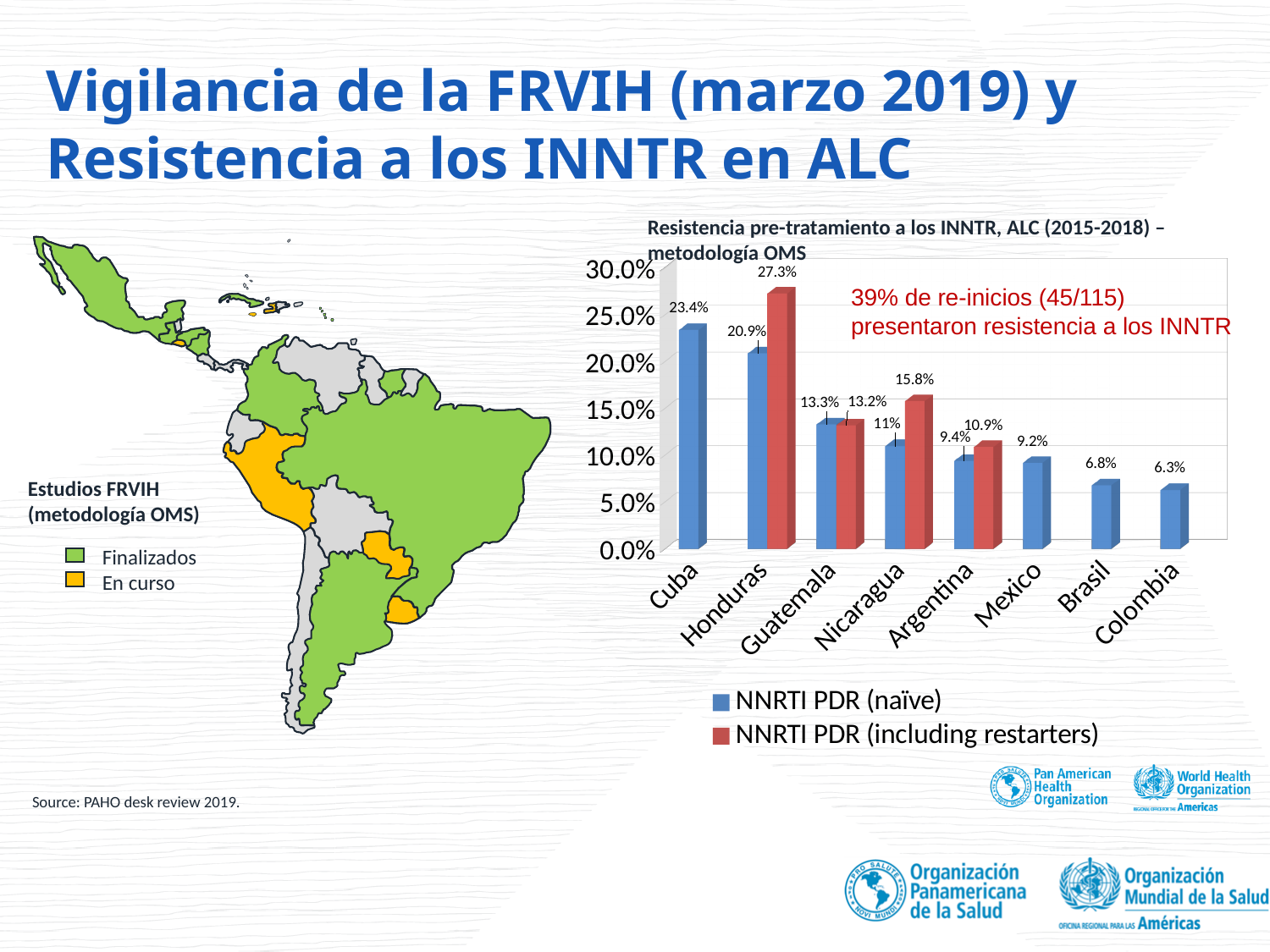
How many countries are shown on the x axis of the chart? 8 What kind of chart is shown on the slide? bar chart What is the difference between the NNRTI PDR (including restarters) and NNRTI PDR (naïve) values for Honduras? 6.4% Which is larger for Nicaragua: NNRTI PDR (naïve) or NNRTI PDR (including restarters)? NNRTI PDR (including restarters) What is the NNRTI PDR (including restarters) value for Honduras? 27.3% Which country has the lowest NNRTI PDR (naïve) value? Colombia What colour represents the NNRTI PDR (including restarters) series? red What is the NNRTI PDR (naïve) value for Cuba? 23.4% How many series does the chart legend list? 2 Which country has the highest NNRTI PDR (naïve) value? Cuba What is the NNRTI PDR (naïve) value for Nicaragua? 11% Is the NNRTI PDR (naïve) value for Mexico greater or less than 10.0%? less